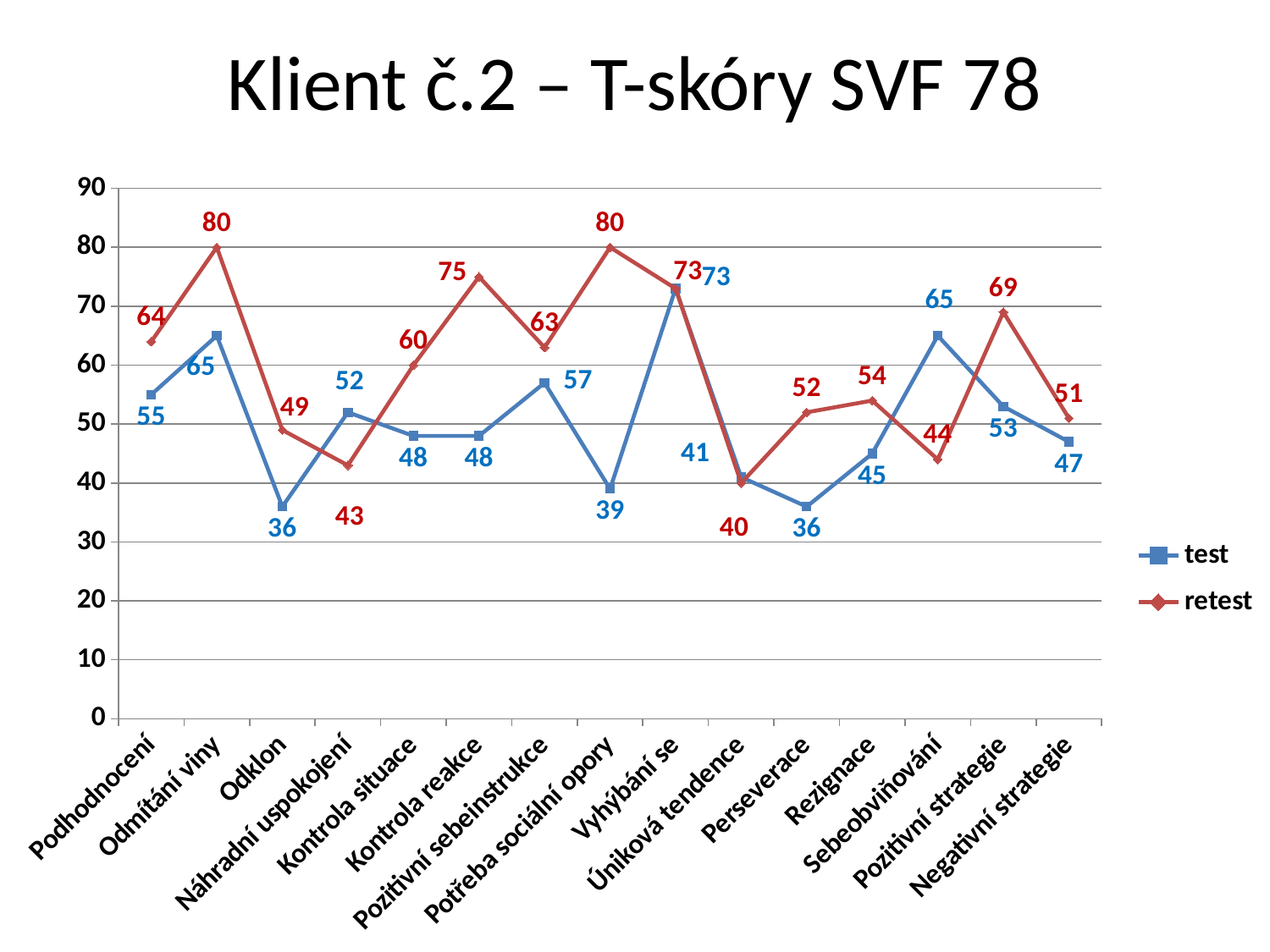
Which category has the highest test value? Vyhýbání se How many series does the legend list? 2 What is the difference between the retest and test values for Potřeba sociální opory? 41 What is the retest value for Kontrola reakce? 75 What type of chart is shown on the slide? line chart What is the title of the chart? Klient č.2 – T-skóry SVF 78 How many categories are plotted along the x axis? 15 What is the retest value for Pozitivní strategie? 69 For Sebeobviňování, which is larger, the test value or the retest value? test What is the test value for Odklon? 36 Which category has the lowest retest value? Úniková tendence Do the test values rise or fall from Perseverace to Sebeobviňování? rise